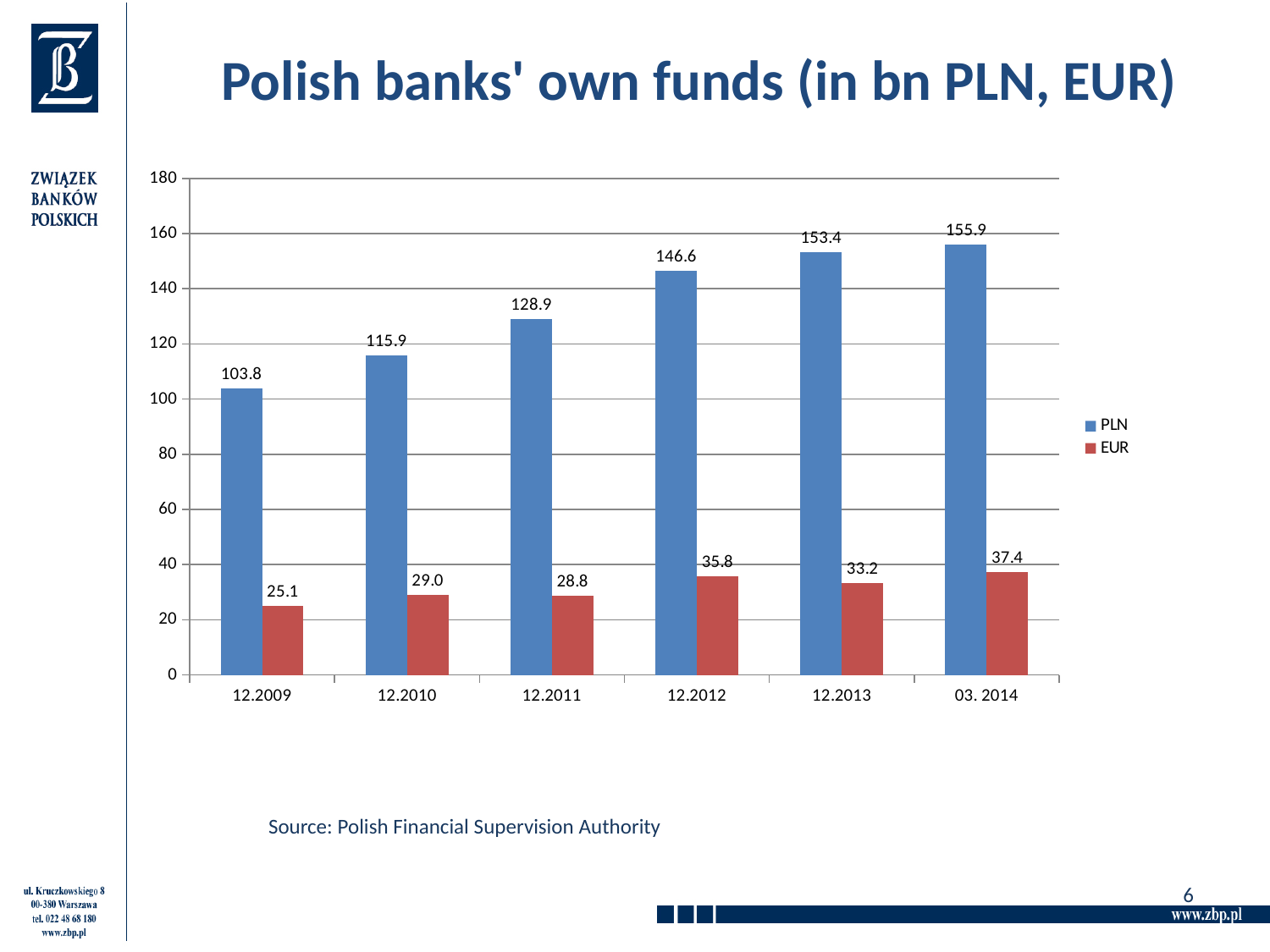
What is the EUR value for 12.2012? 35.8 What is the PLN value for 12.2011? 128.9 How many periods are shown on the x axis? 6 How many series does the legend list? 2 What is the PLN value for 03. 2014? 155.9 What kind of chart is shown on the slide? bar chart Which period has the highest PLN value? 03. 2014 Which is larger, the EUR value for 12.2010 or for 12.2011? 12.2010 Which period has the lowest EUR value? 12.2009 Is the PLN value for 12.2010 greater or less than 100? greater Do the PLN values rise or fall from 12.2009 to 03. 2014? rise What is the difference between the PLN values for 12.2013 and 12.2012? 6.8